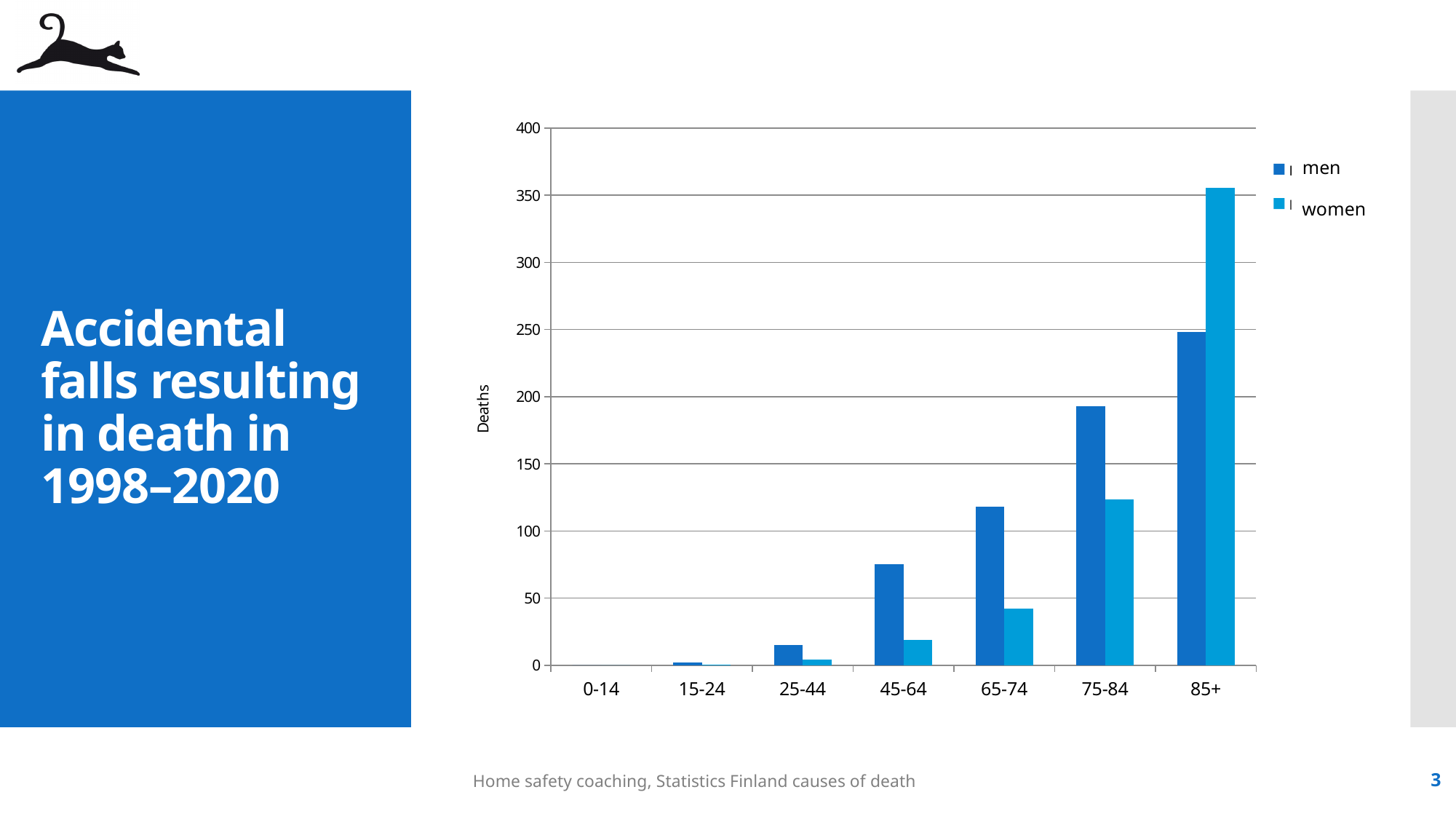
Which age group has the highest number of deaths for men? 85+ What is the label on the vertical axis of the chart? Deaths In the 75-84 age group, which series has the larger value, men or women? men Is the value for women in the 85+ age group greater or less than 300? greater How many series does the legend list? 2 Is the value for men in the 45-64 age group greater or less than 100? less Which age group has the highest number of deaths for women? 85+ Is the value for men in the 85+ age group greater or less than 200? greater In the 85+ age group, which series has the larger value, men or women? women What kind of chart is shown on the slide? bar chart Do the values for women rise or fall as the age groups increase along the x axis? rise How many age groups are shown on the x axis? 7